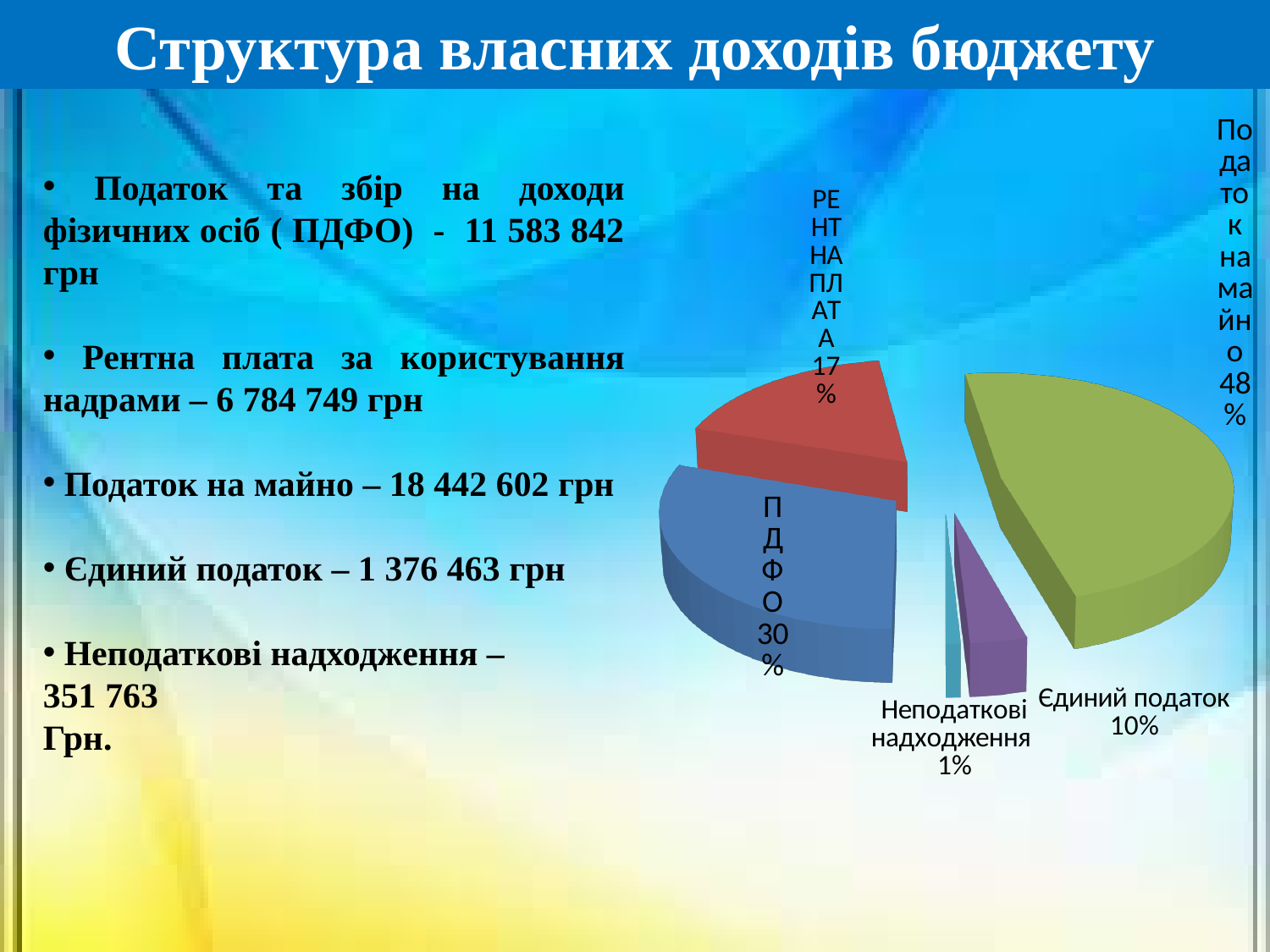
How many slices does the pie chart have? 5 Which is larger, the share for ПДФО or the share for Рентна плата? ПДФО What colour is the slice for Податок на майно? Green Which slice of the pie is the largest? Податок на майно What share of the pie does Неподаткові надходження have? 1% What kind of chart is shown on the slide? Pie chart What share of the pie does Рентна плата have? 17% What share of the pie does Податок на майно have? 48% Which slice of the pie is the smallest? Неподаткові надходження What is the difference in percentage points between Податок на майно and ПДФО? 18